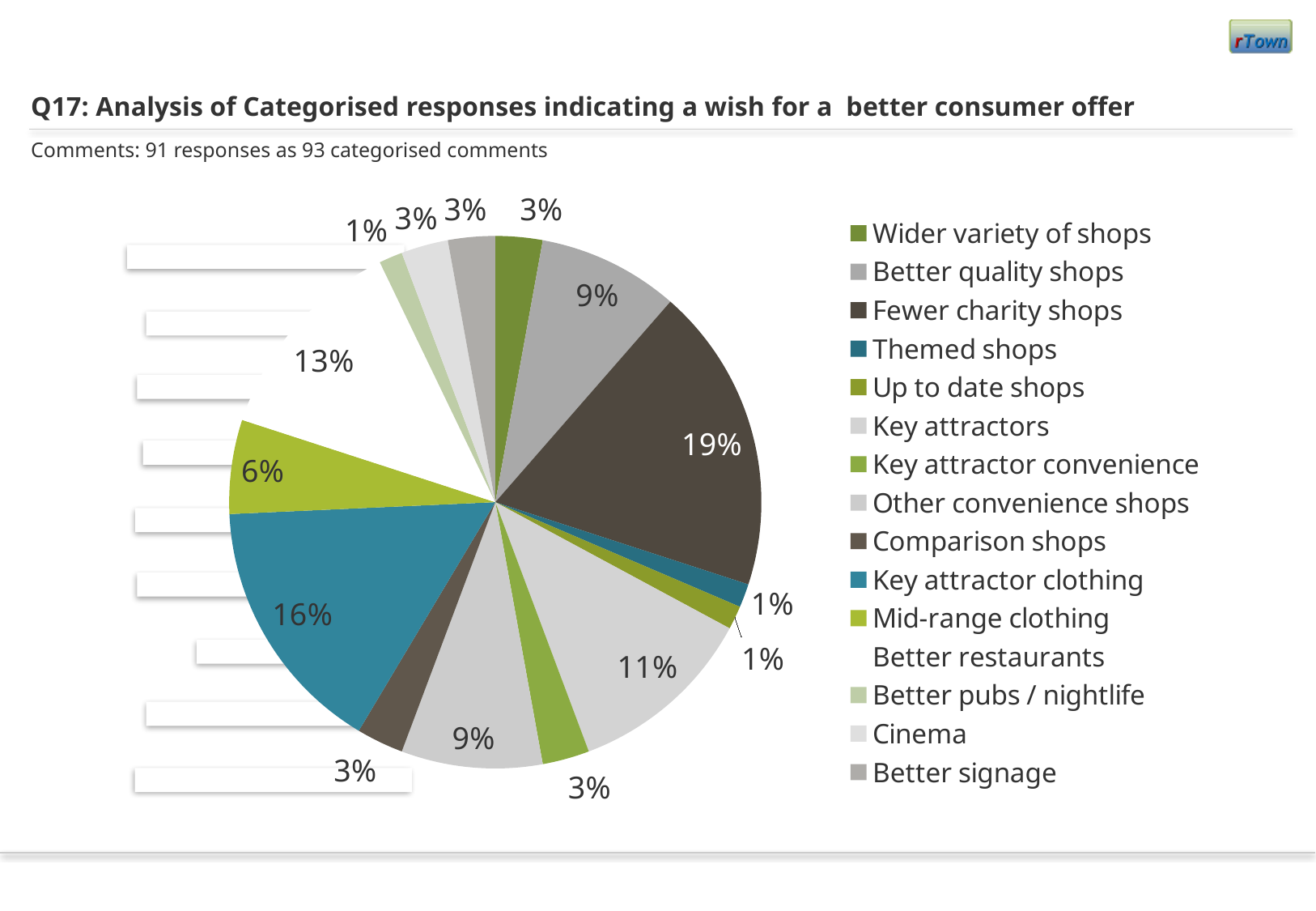
Which category has the largest share of the pie? Fewer charity shops What kind of chart is shown on the slide? Pie chart What share of the pie does 'Fewer charity shops' account for? 19% What percentage is shown for 'Key attractors'? 11% What percentage is shown for 'Key attractor clothing'? 16% What is the title of the slide's chart? Q17: Analysis of Categorised responses indicating a wish for a better consumer offer Which has the larger share: 'Key attractors' or 'Better quality shops'? Key attractors What percentage is shown for 'Mid-range clothing'? 6% What is the difference in percentage points between 'Fewer charity shops' and 'Key attractor clothing'? 3 percentage points According to the subtitle, how many categorised comments does the chart represent? 93 What percentage is shown for 'Better restaurants'? 13% How many categories does the legend of the pie chart list? 15